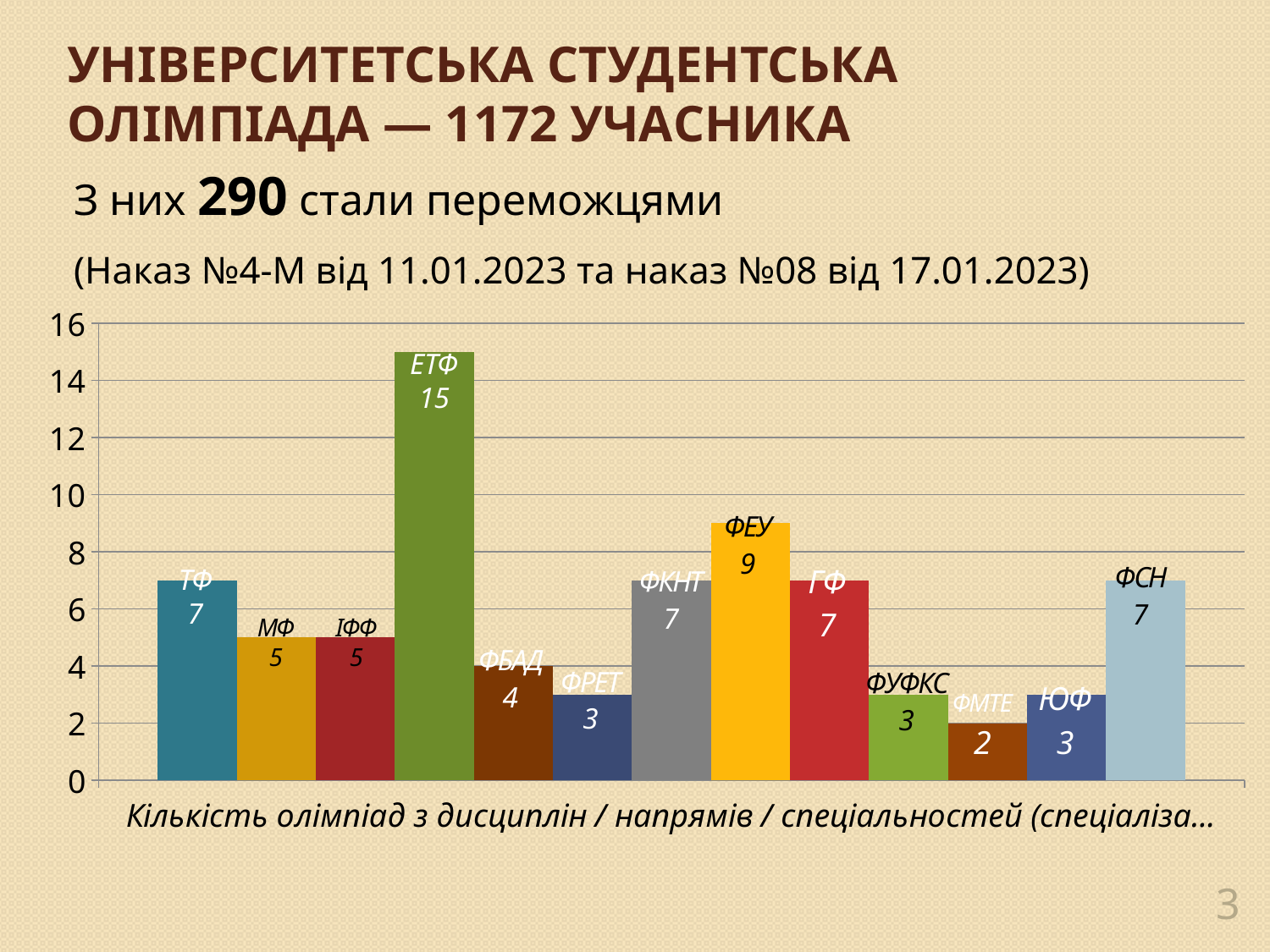
Which faculty has the lowest value in the chart? ФМТЕ What is the value for ЕТФ? 15 What is the value for ФЕУ? 9 How many bars (faculties) are plotted in the chart? 13 Which faculty has the highest value in the chart? ЕТФ What is the value for ФБАД? 4 Which is larger, the value for ФКНТ or the value for ФРЕТ? ФКНТ What is the value for ФМТЕ? 2 Is the value for ЕТФ greater or less than 14? greater What is the difference between the values for ЕТФ and ФЕУ? 6 What kind of chart is shown on the slide? bar chart What is the x-axis title of the chart? Кількість олімпіад з дисциплін / напрямів / спеціальностей (спеціаліза…